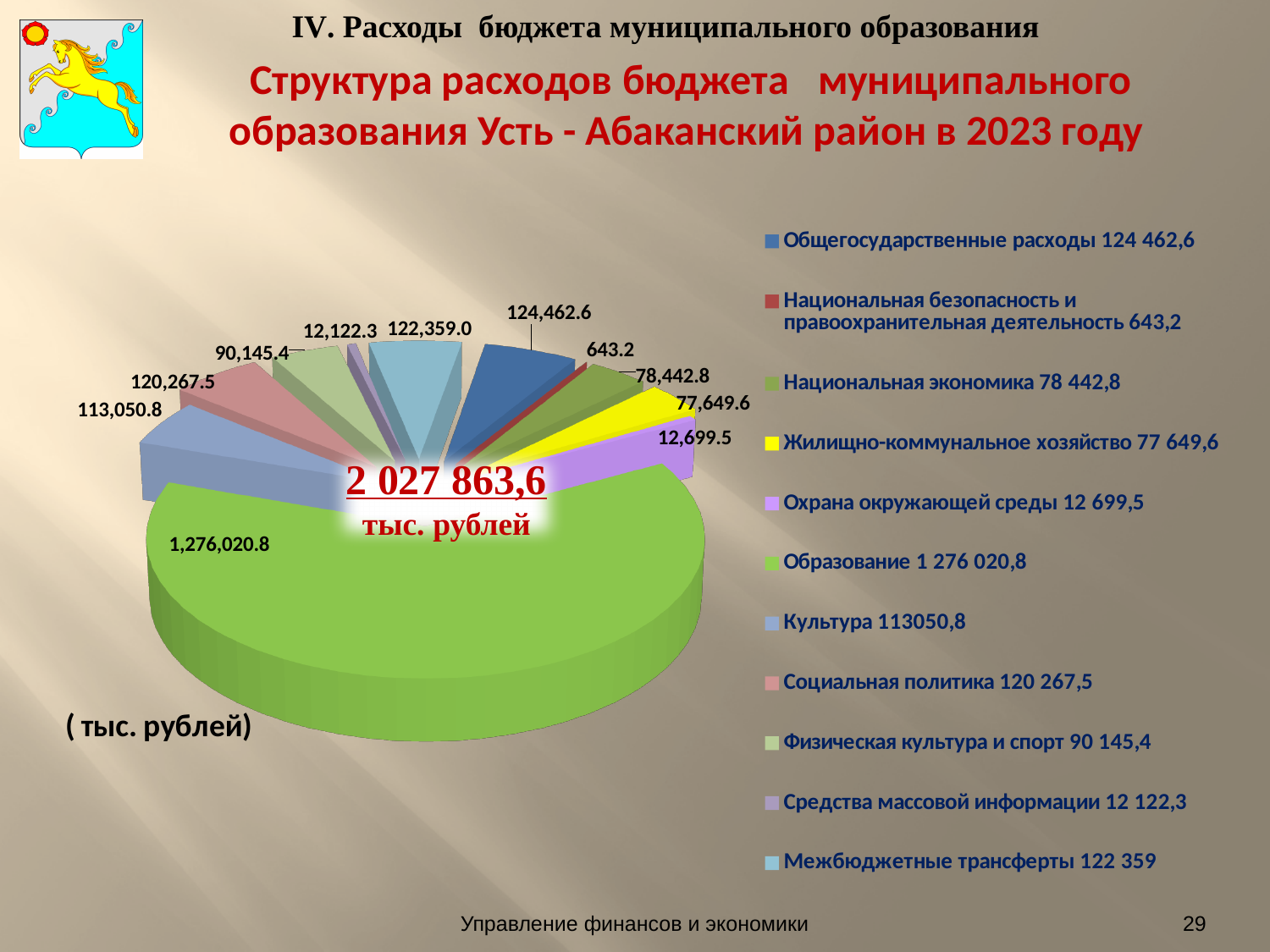
Which category has the smallest slice of the pie chart? Национальная безопасность и правоохранительная деятельность What total amount is printed in the centre of the pie chart? 2 027 863,6 тыс. рублей What kind of chart is shown on the slide? pie chart What is the difference between the values for Национальная экономика and Жилищно-коммунальное хозяйство? 793.2 Which category has the largest slice of the pie chart? Образование What is the difference between the values for Социальная политика and Культура? 7,216.7 What is the value for Образование on the pie chart? 1,276,020.8 Which is larger, the value for Социальная политика or the value for Культура? Социальная политика What is the value for Межбюджетные трансферты on the pie chart? 122,359.0 How many categories does the legend of the pie chart list? 11 What is the value for Общегосударственные расходы on the pie chart? 124,462.6 What is the value for Жилищно-коммунальное хозяйство on the pie chart? 77,649.6